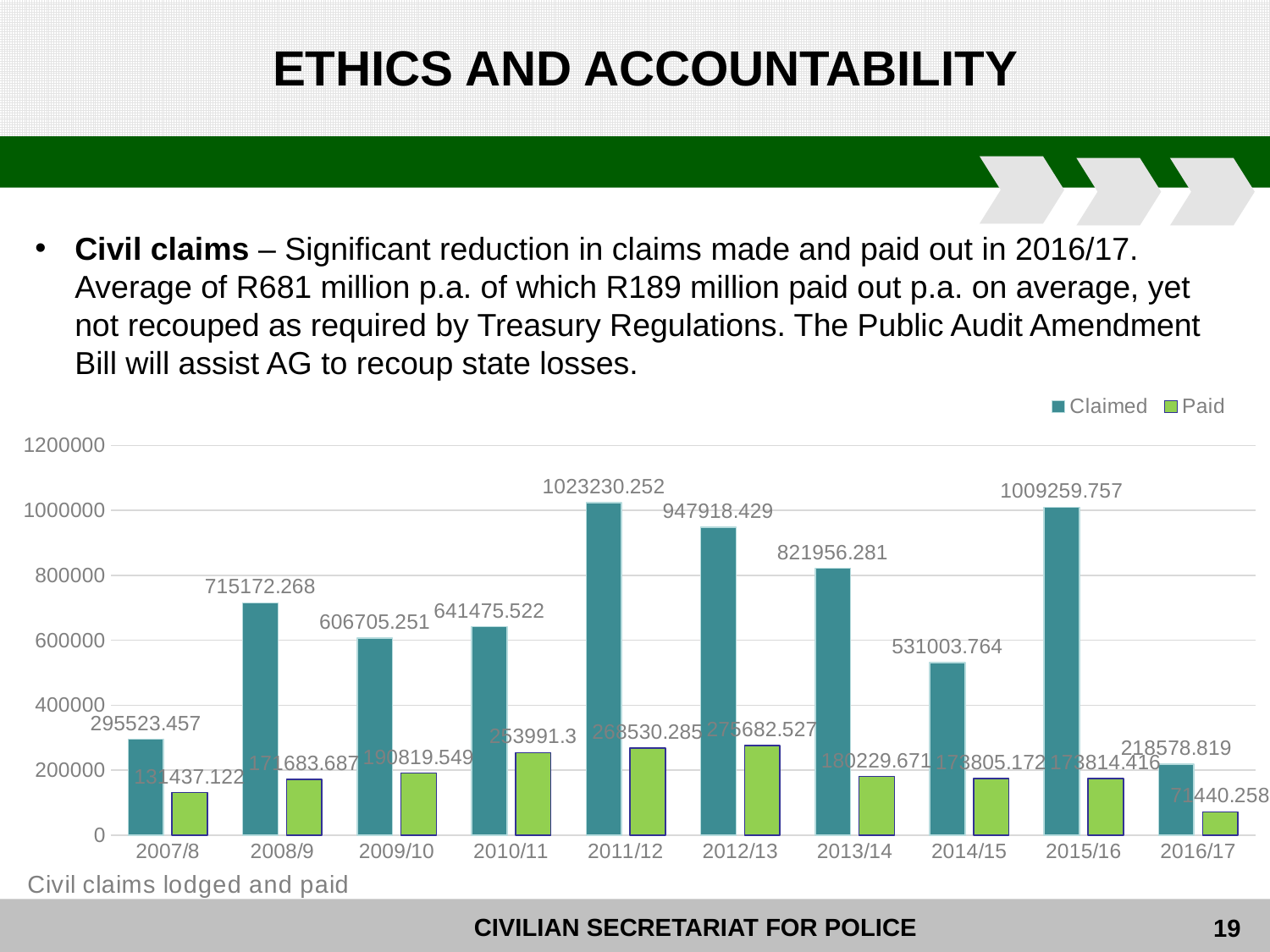
How many series does the legend list? 2 How many financial years are shown on the x axis? 10 What is the Paid value for 2012/13? 275682.527 Is the Claimed value for 2014/15 greater or less than 600000? less What is the Claimed value for 2014/15? 531003.764 What is the difference between the Claimed values for 2008/9 and 2009/10? 108467.017 Which is larger, the Claimed value for 2012/13 or for 2013/14? 2012/13 What is the Claimed value for 2011/12? 1023230.252 Which year has the highest Claimed value? 2011/12 Which year has the lowest Paid value? 2016/17 What is the Paid value for 2009/10? 190819.549 What type of chart is shown on the slide? bar chart